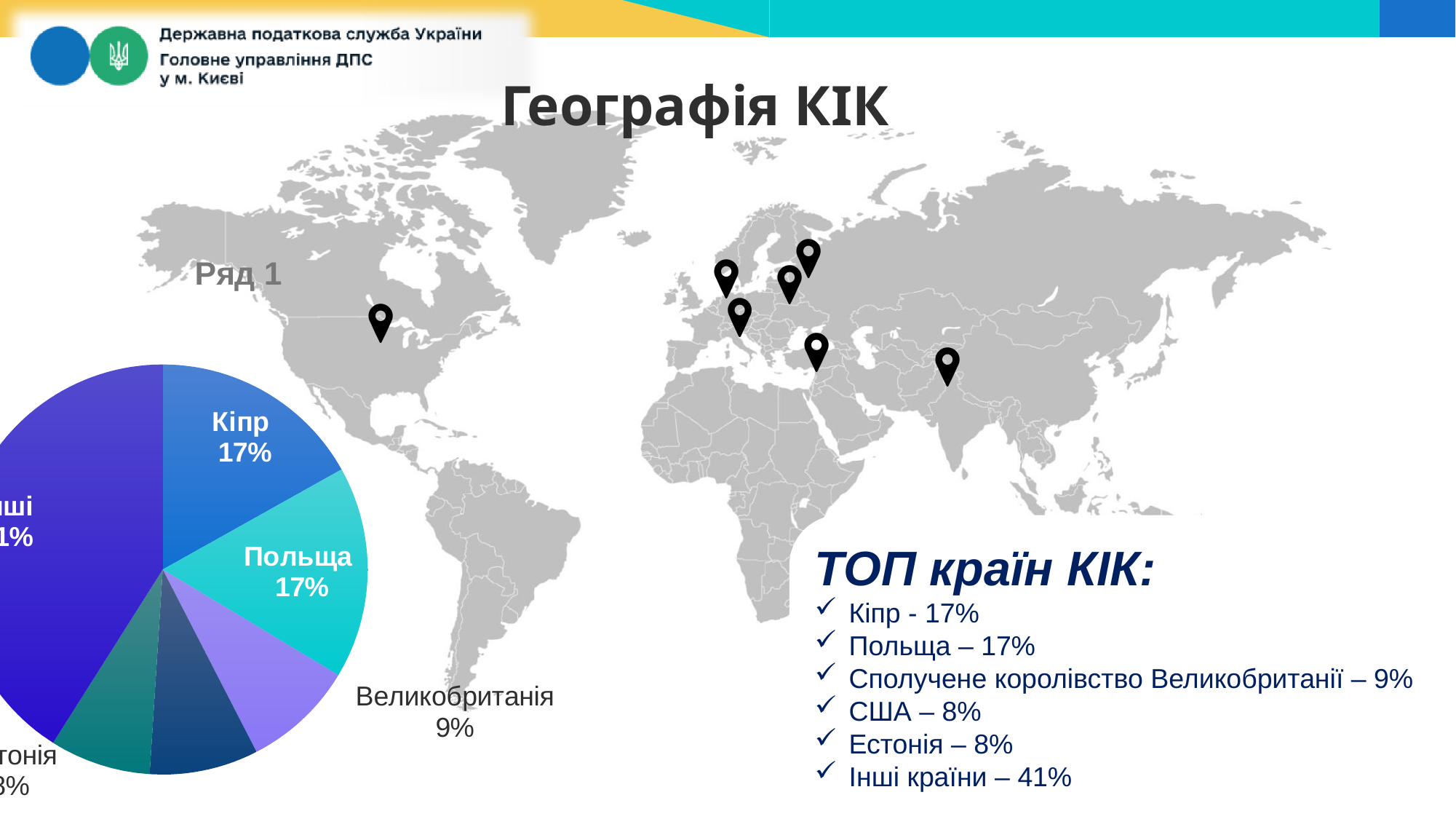
Which category has the largest slice in the pie chart? Інші країни How many slices does the pie chart have? 6 What kind of chart is shown on the slide? pie chart What is the value shown for Великобританія in the pie chart? 9% What colour is the slice for Польща in the pie chart? turquoise What is the difference between the shares of Польща and Великобританія in the pie chart? 8% What share of the pie does Кіпр have? 17% What is the title shown on the pie chart? Ряд 1 Is the share for Кіпр in the pie chart greater or less than 10%? greater Which is larger in the pie chart, the slice for Кіпр or the slice for Великобританія? Кіпр What share of the pie does Польща have? 17%